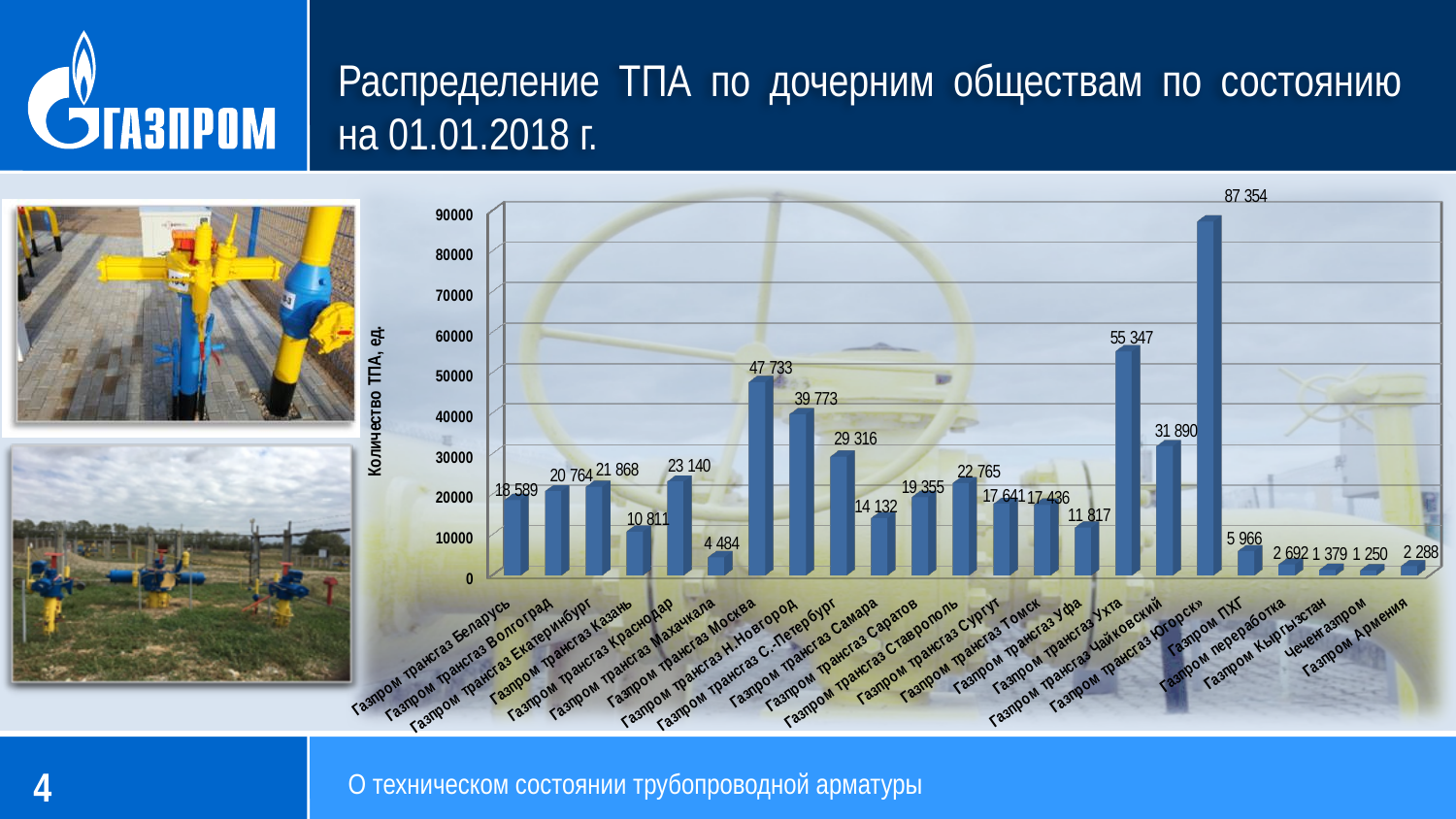
What type of chart is shown on the slide? Bar chart What is the value shown for Газпром трансгаз Ухта? 55 347 Which subsidiary has the highest number of ТПА? Газпром трансгаз Югорск What is the value shown for Газпром трансгаз Москва? 47 733 Which subsidiary has the lowest number of ТПА? Чеченгазпром What is the title of the vertical axis of the chart? Количество ТПА, ед. Which is larger: the value for Газпром трансгаз Н.Новгород or Газпром трансгаз С.-Петербург? Газпром трансгаз Н.Новгород What is the value shown for Газпром трансгаз Махачкала? 4 484 How many subsidiaries are shown on the x axis of the chart? 23 Is the value for Газпром трансгаз Краснодар greater or less than 20000? greater What is the difference between the values for Газпром трансгаз Ухта and Газпром трансгаз Чайковский? 23 457 What is the value shown for Газпром трансгаз Югорск? 87 354